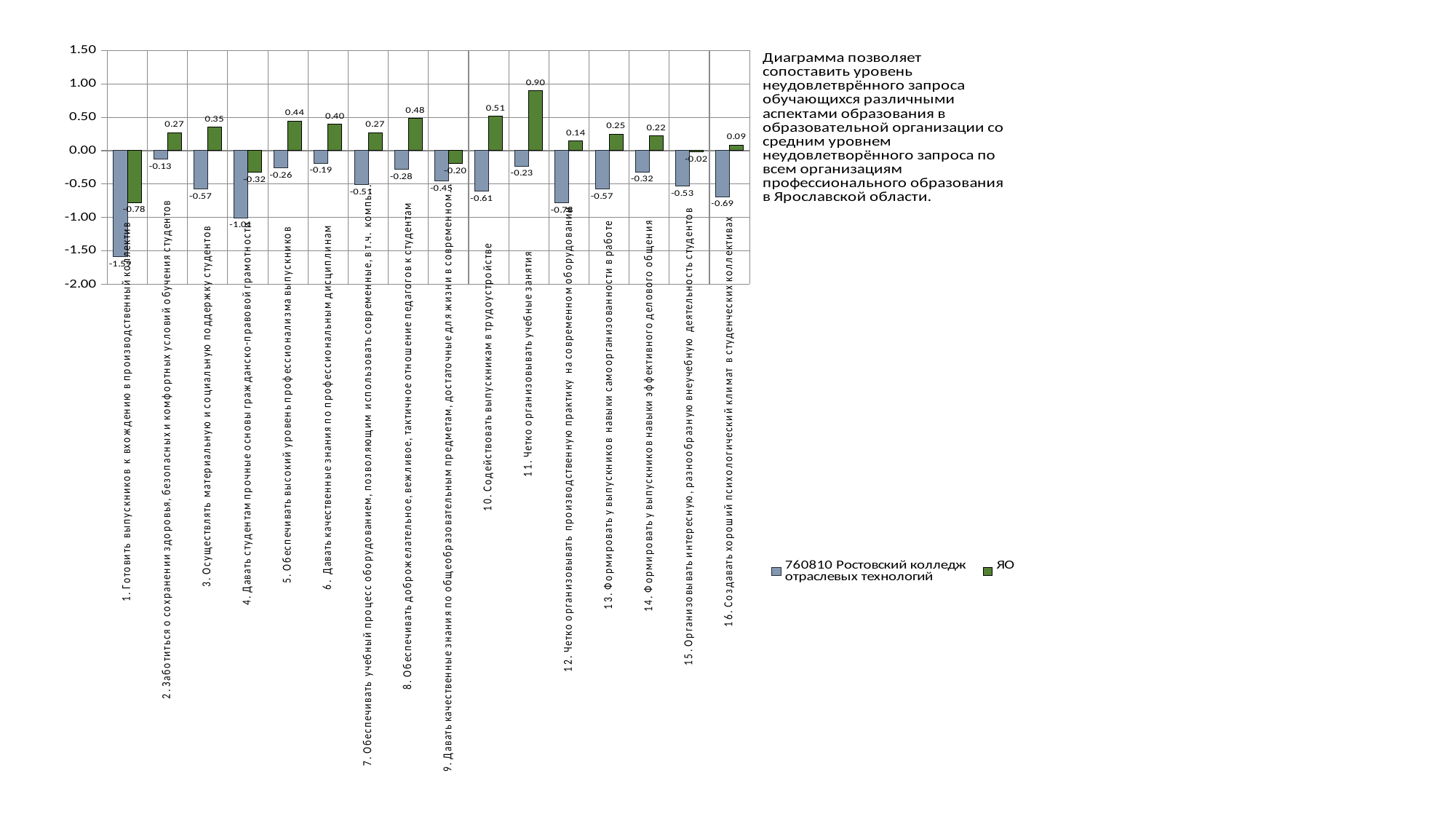
What type of chart is shown on the slide? bar chart What is the value of the ЯО series for category 11 (Четко организовывать учебные занятия)? 0.90 Which category has the lowest value for the ЯО series? 1. Готовить выпускников к вхождению в производственный коллектив What is the value of the ЯО series for category 8 (Обеспечивать доброжелательное, вежливое, тактичное отношение педагогов к студентам)? 0.48 How many categories are plotted along the x axis? 16 What is the value of the 760810 Ростовский колледж отраслевых технологий series for category 10 (Содействовать выпускникам в трудоустройстве)? -0.61 How many series does the legend list? 2 Which category has the highest value for the 760810 Ростовский колледж отраслевых технологий series? 2. Заботиться о сохранении здоровья, безопасных и комфортных условий обучения студентов What is the difference between the ЯО value and the 760810 Ростовский колледж отраслевых технологий value for category 5 (Обеспечивать высокий уровень профессионализма выпускников)? 0.70 For category 9 (Давать качественные знания по общеобразовательным предметам), which series has the larger value: ЯО or 760810 Ростовский колледж отраслевых технологий? ЯО Which category has the highest value for the ЯО series? 11. Четко организовывать учебные занятия Which series is shown in green in the legend? ЯО